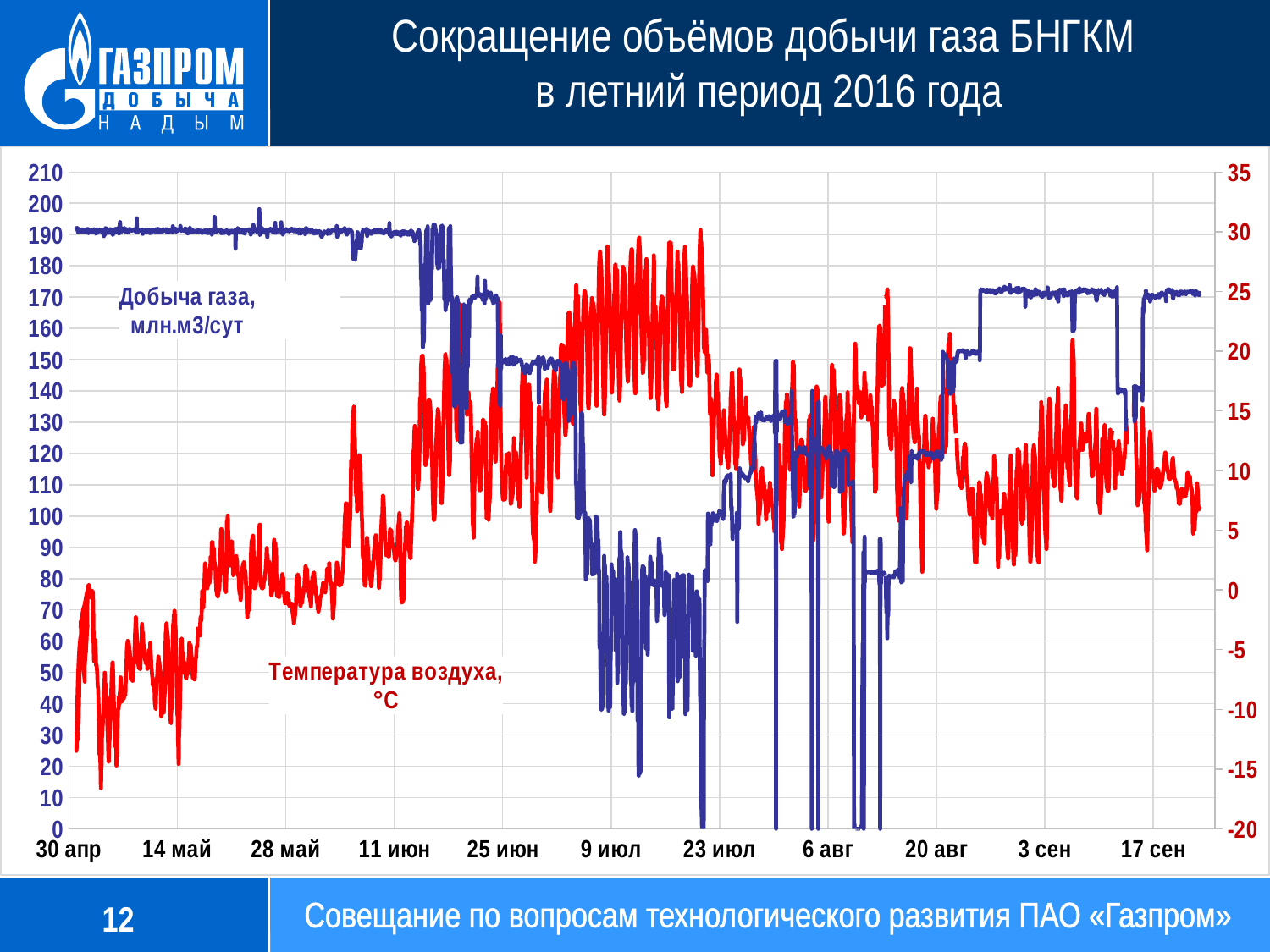
Is gas production higher around 14 мая or around 9 июл? 14 мая How many date labels are shown on the x axis? 11 Is the gas production value around 9 июл greater or less than 100? less Is the air temperature around 30 апр greater or less than 10 °C? less Is the gas production value around 17 сен greater or less than 150? greater In what units is the gas production series (Добыча газа) measured? млн.м3/сут What kind of chart is shown on the slide? line chart How many data series are plotted on the chart? 2 What is the title of the chart on the slide? Сокращение объёмов добычи газа БНГКМ в летний период 2016 года Does gas production rise or fall between 30 апр and 9 июл? fall